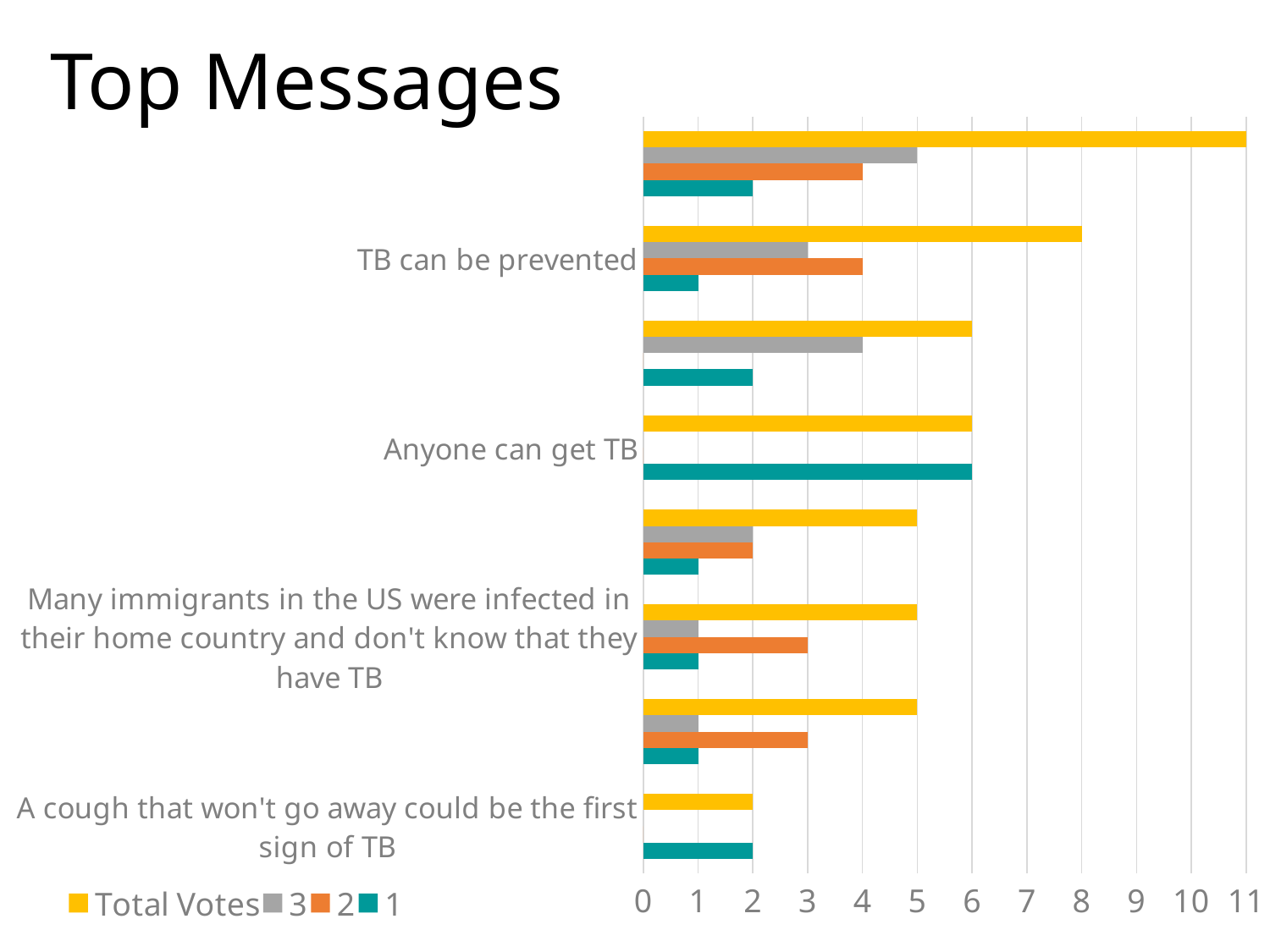
What is the value of series "3" for "TB can be prevented"? 3 Which category has the lowest Total Votes? A cough that won't go away could be the first sign of TB What kind of chart is shown on the slide? bar chart What are the legend entries of the chart? Total Votes, 3, 2, 1 Which has more Total Votes: "TB can be prevented" or "Many immigrants in the US were infected in their home country and don't know that they have TB"? TB can be prevented What is the difference in Total Votes between "TB can be prevented" and "Anyone can get TB"? 2 What is the Total Votes value for "TB can be prevented"? 8 What is the Total Votes value for "A cough that won't go away could be the first sign of TB"? 2 How many series does the legend list? 4 What is the value of series "1" for "Anyone can get TB"? 6 Is the Total Votes value for "TB can be prevented" greater or less than 5? greater What is the value of series "2" for "Many immigrants in the US were infected in their home country and don't know that they have TB"? 3